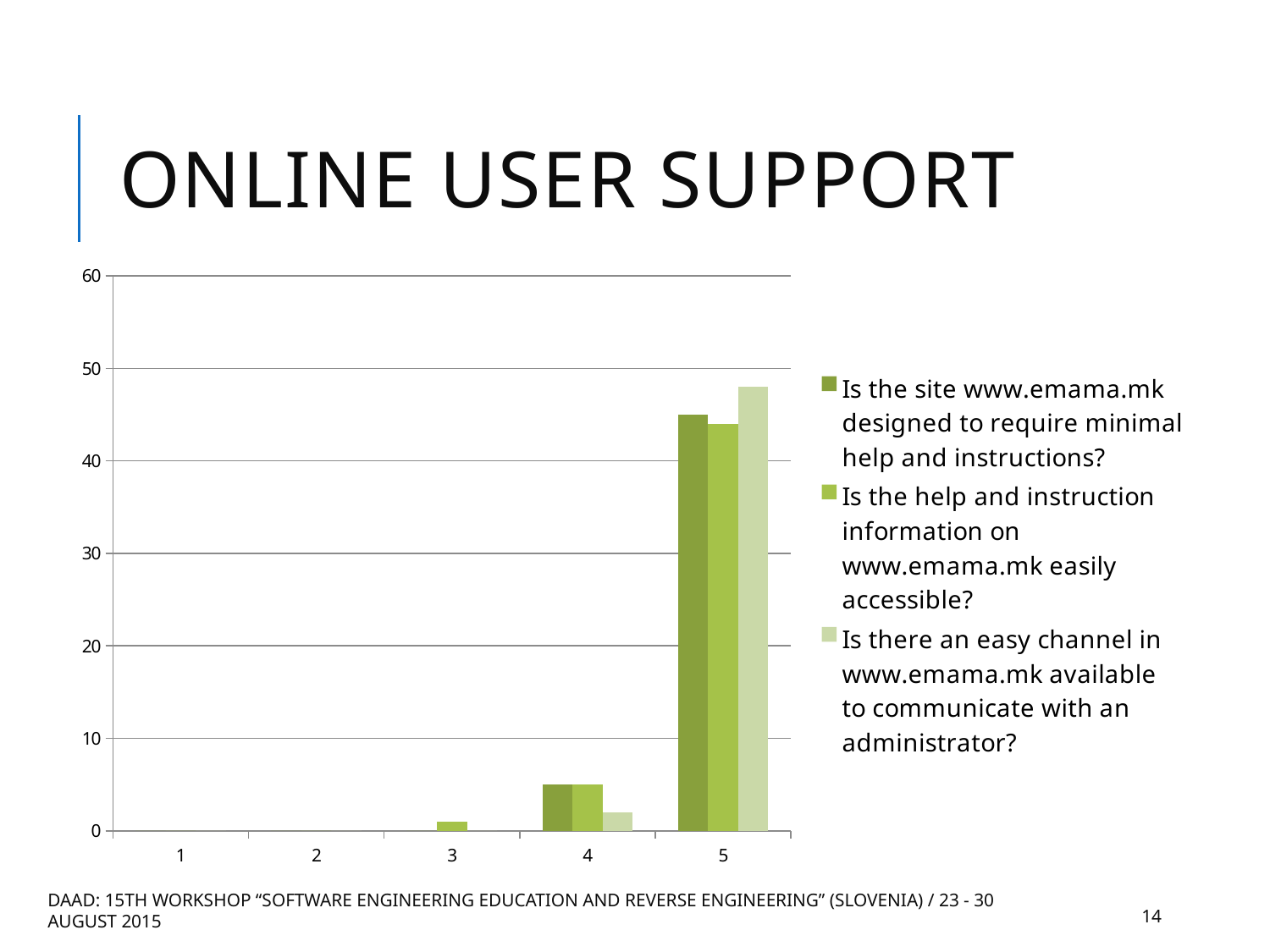
How many categories are shown on the x axis of the chart? 5 Which x-axis category has the highest bars in the chart? 5 What is the title of the slide containing the chart? ONLINE USER SUPPORT What is the maximum value shown on the chart's y axis? 60 Is the value for category 4 in the series "Is the site www.emama.mk designed to require minimal help and instructions?" greater or less than 10? less For category 5, which series has the larger value: "Is there an easy channel in www.emama.mk available to communicate with an administrator?" or "Is the help and instruction information on www.emama.mk easily accessible?" Is there an easy channel in www.emama.mk available to communicate with an administrator? Do the values in the chart generally rise or fall as the x-axis categories go from 1 to 5? rise How many series does the chart's legend list? 3 What kind of chart is shown on the slide? bar chart Is the value for category 5 in the series "Is there an easy channel in www.emama.mk available to communicate with an administrator?" greater or less than 40? greater Is the value for category 5 in the series "Is the help and instruction information on www.emama.mk easily accessible?" greater or less than 50? less For category 4, which series has the smaller value: "Is there an easy channel in www.emama.mk available to communicate with an administrator?" or "Is the site www.emama.mk designed to require minimal help and instructions?" Is there an easy channel in www.emama.mk available to communicate with an administrator?